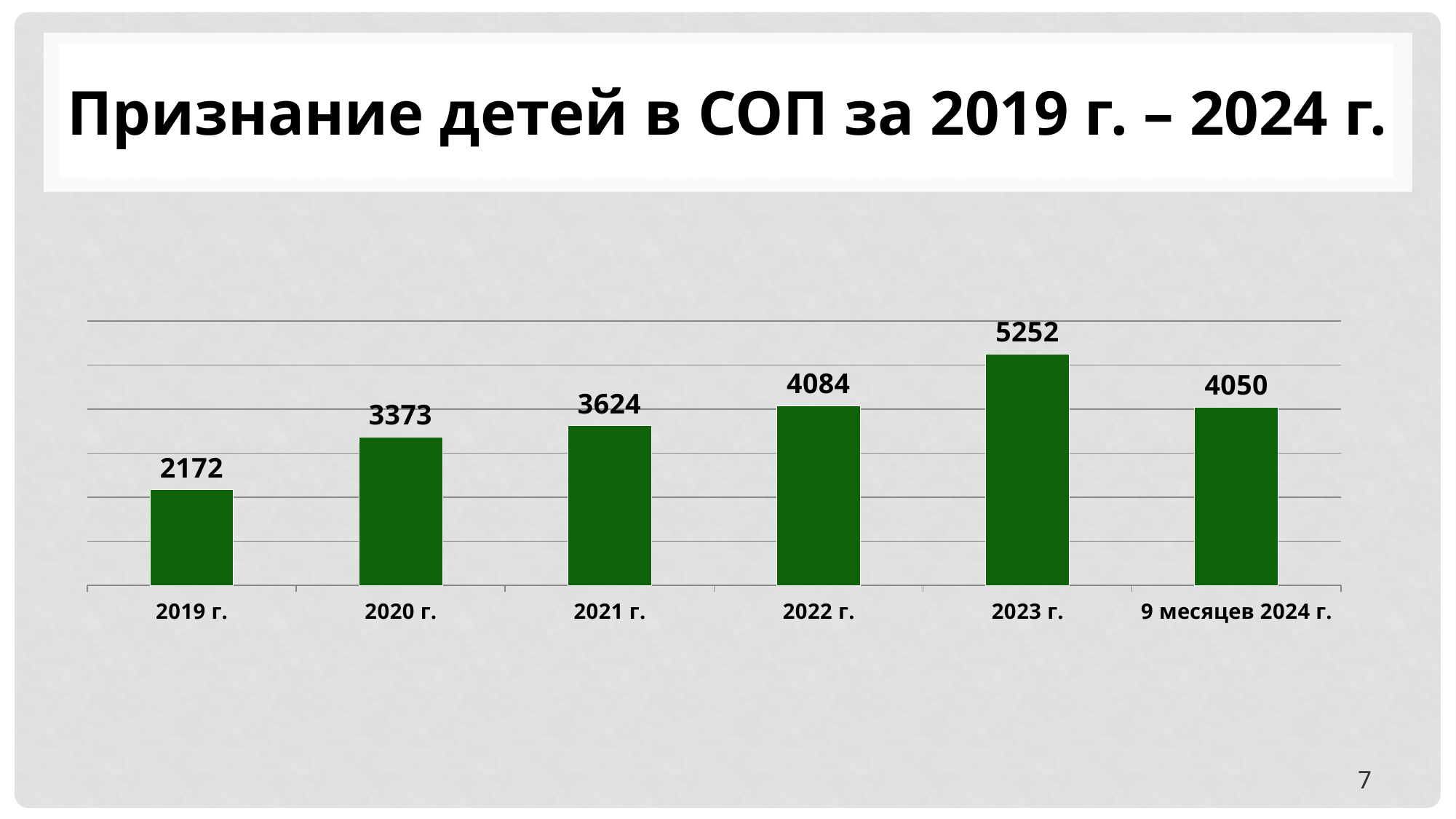
What kind of chart is shown on the slide? bar chart Do the values rise or fall from 2019 г. to 2023 г.? rise What is the difference between the values for 2020 г. and 2019 г.? 1201 What is the difference between the values for 2023 г. and 2022 г.? 1168 What is the value for 9 месяцев 2024 г.? 4050 What is the value for 2019 г.? 2172 Which category has the lowest value? 2019 г. What is the value for 2021 г.? 3624 What is the title of the slide? Признание детей в СОП за 2019 г. – 2024 г. Which is larger, the value for 2022 г. or the value for 9 месяцев 2024 г.? 2022 г. Which category has the highest value? 2023 г. How many categories are shown on the x axis? 6